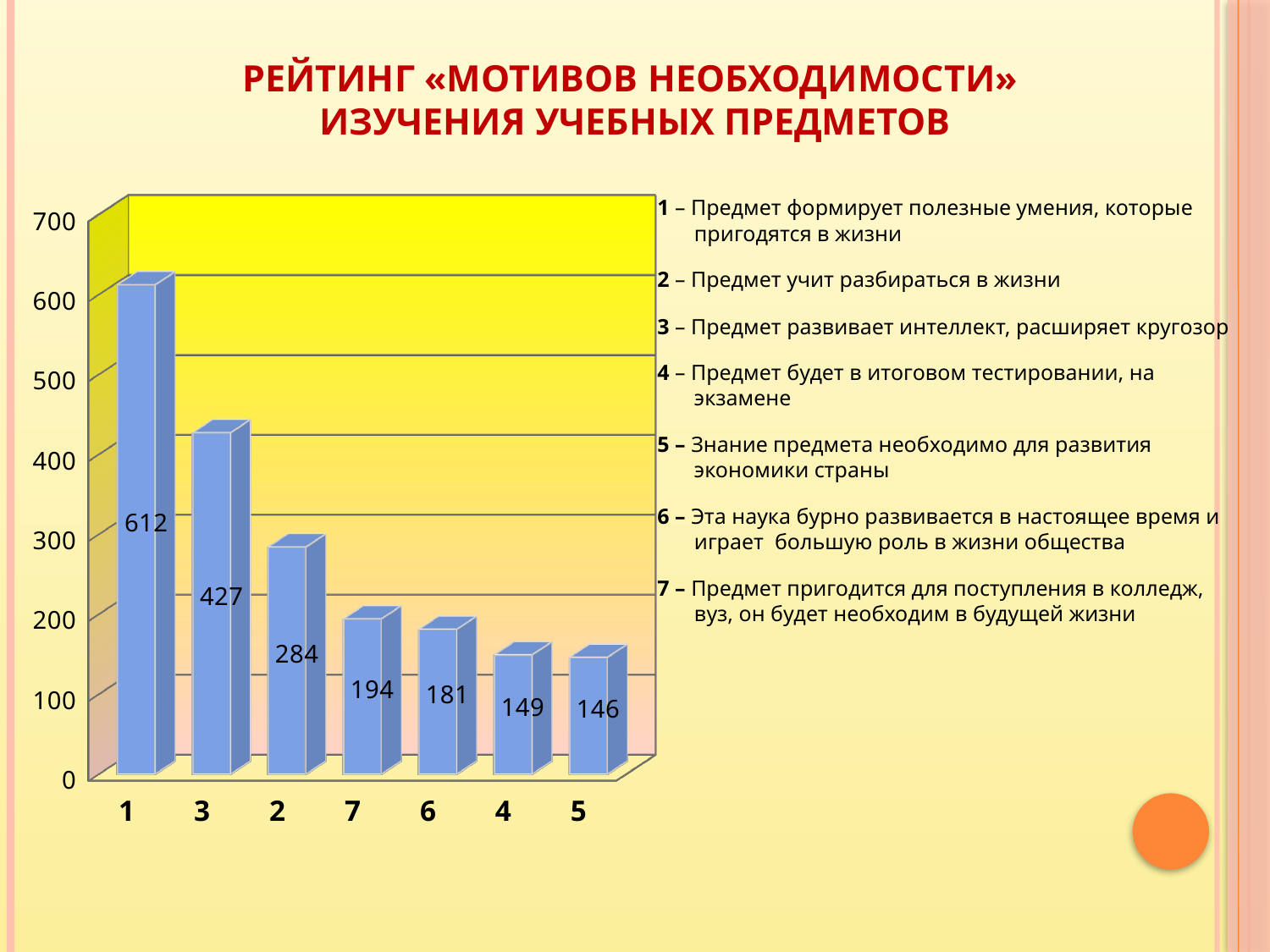
Which category has the lowest value? 5 What is the difference between the values for category 2 and category 6? 103 Which is larger, the value for category 3 or the value for category 2? 3 Is the value for category 2 greater or less than 300? less What kind of chart is shown on the slide? bar chart What is the value for category 7? 194 How many categories are shown on the x axis? 7 What is the value for category 5? 146 Do the values rise or fall from left to right along the x axis? fall What is the difference between the values for category 1 and category 3? 185 Which category has the highest value? 1 What is the value for category 1? 612